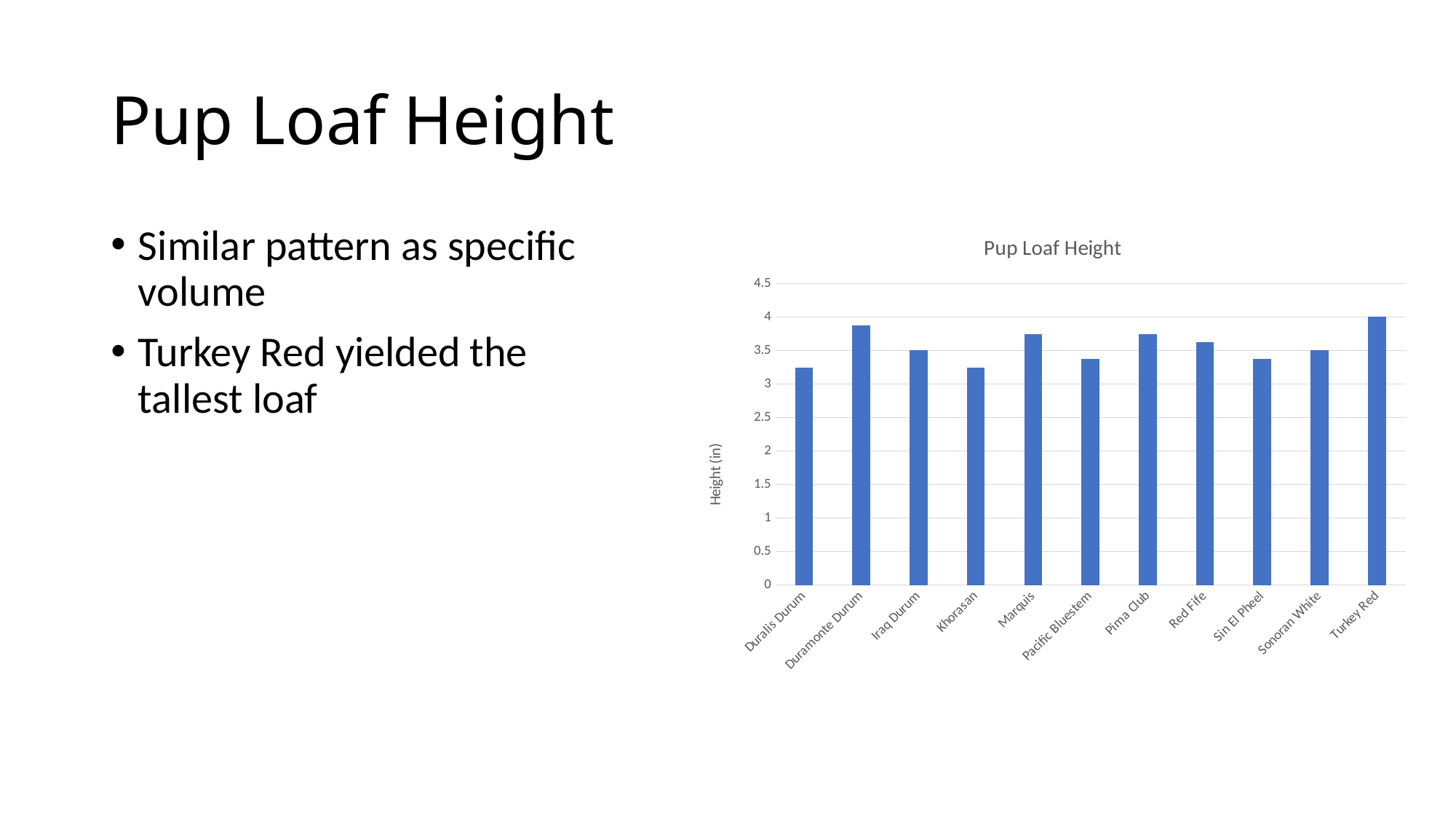
Is the value for Khorasan greater or less than 3.5? less What is the label of the vertical axis of the chart? Height (in) What type of chart is shown on the slide? bar chart Is the value for Red Fife greater or less than 4? less How many wheat varieties are plotted in the chart? 11 Which variety has the tallest pup loaf height? Turkey Red Is the value for Duramonte Durum greater or less than 3.5? greater Which is larger, the value for Marquis or the value for Sin El Pheel? Marquis Which is larger, the value for Duramonte Durum or the value for Iraq Durum? Duramonte Durum What is the pup loaf height for Turkey Red? 4 What is the title of the chart? Pup Loaf Height